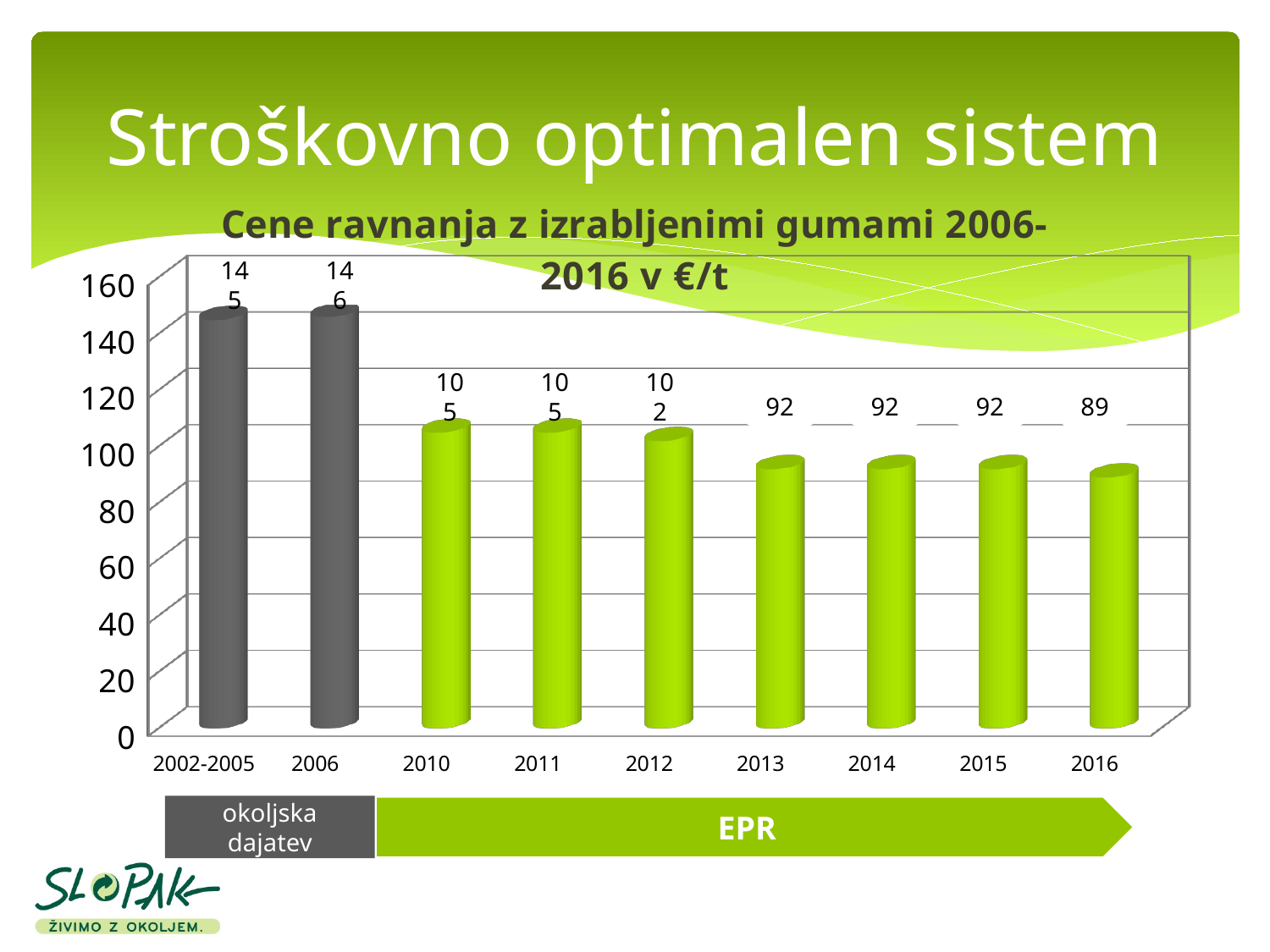
Which category has the lowest value? 2016 What is the difference between the values for 2006 and 2016? 57 Which is larger, the value for 2002-2005 or the value for 2010? 2002-2005 What kind of chart is shown on the slide? bar chart How many categories are shown on the x axis? 9 Do the values generally rise or fall from 2002-2005 to 2016? fall What is the value for 2006? 146 What is the value for 2012? 102 What is the difference between the values for 2010 and 2013? 13 What is the value for 2016? 89 Which category has the highest value? 2006 What is the value for 2010? 105